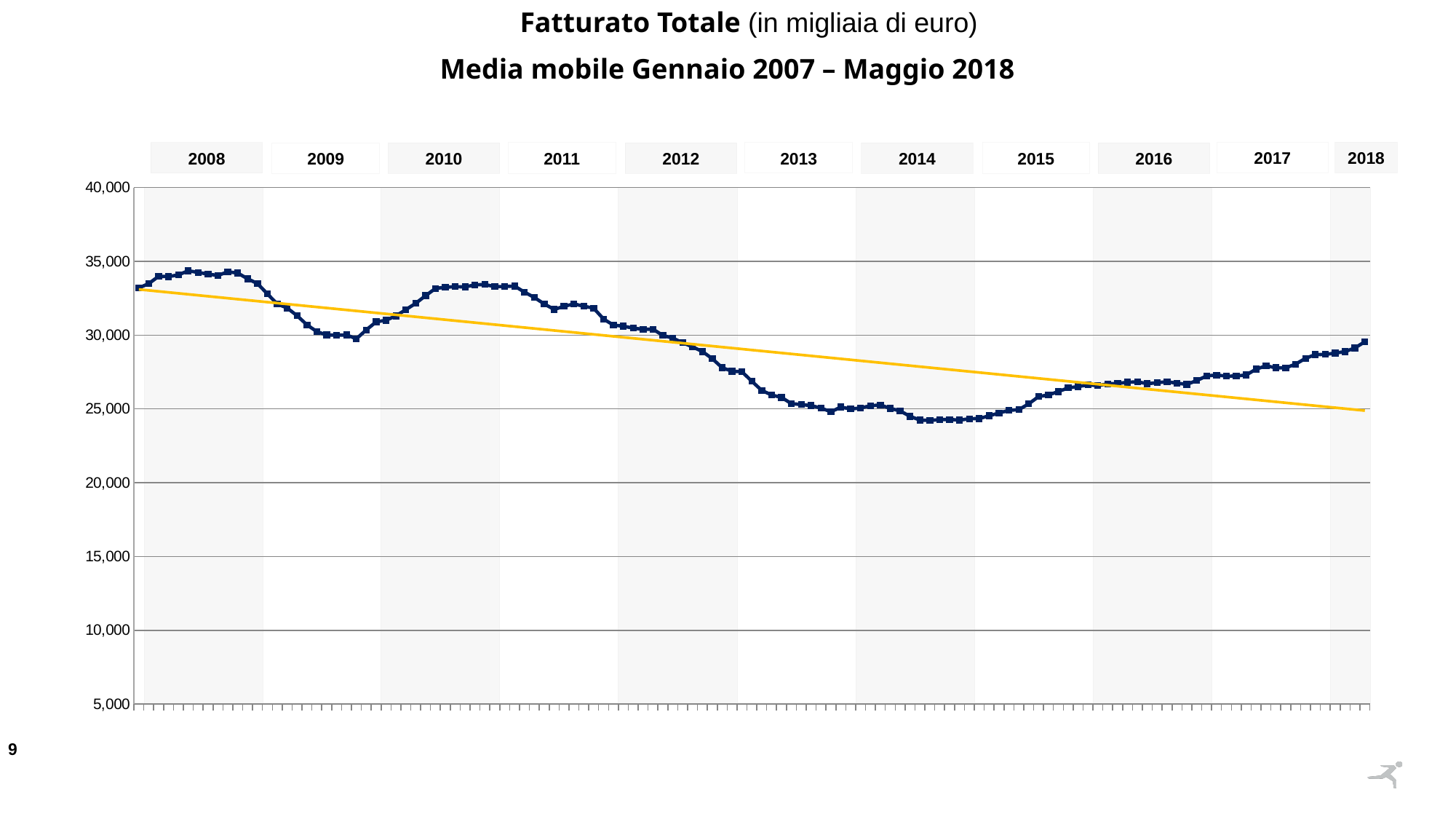
Is the moving average value during 2016 greater or less than 30,000? less What kind of chart is shown on the slide? line chart Does the yellow trend line rise or fall from left to right across the chart? fall Is the moving average value during 2014 greater or less than 30,000? less Which is higher, the moving average in 2008 or in 2014? 2008 Is the moving average value at the start of 2008 greater or less than 30,000? greater How many year labels are shown along the top of the chart? 11 What is the highest value shown on the vertical axis? 40,000 What is the lowest value shown on the vertical axis? 5,000 In which year does the moving average reach its lowest level? 2014 What is the title of the chart? Fatturato Totale (in migliaia di euro) What period does the moving average cover according to the subtitle? Gennaio 2007 – Maggio 2018